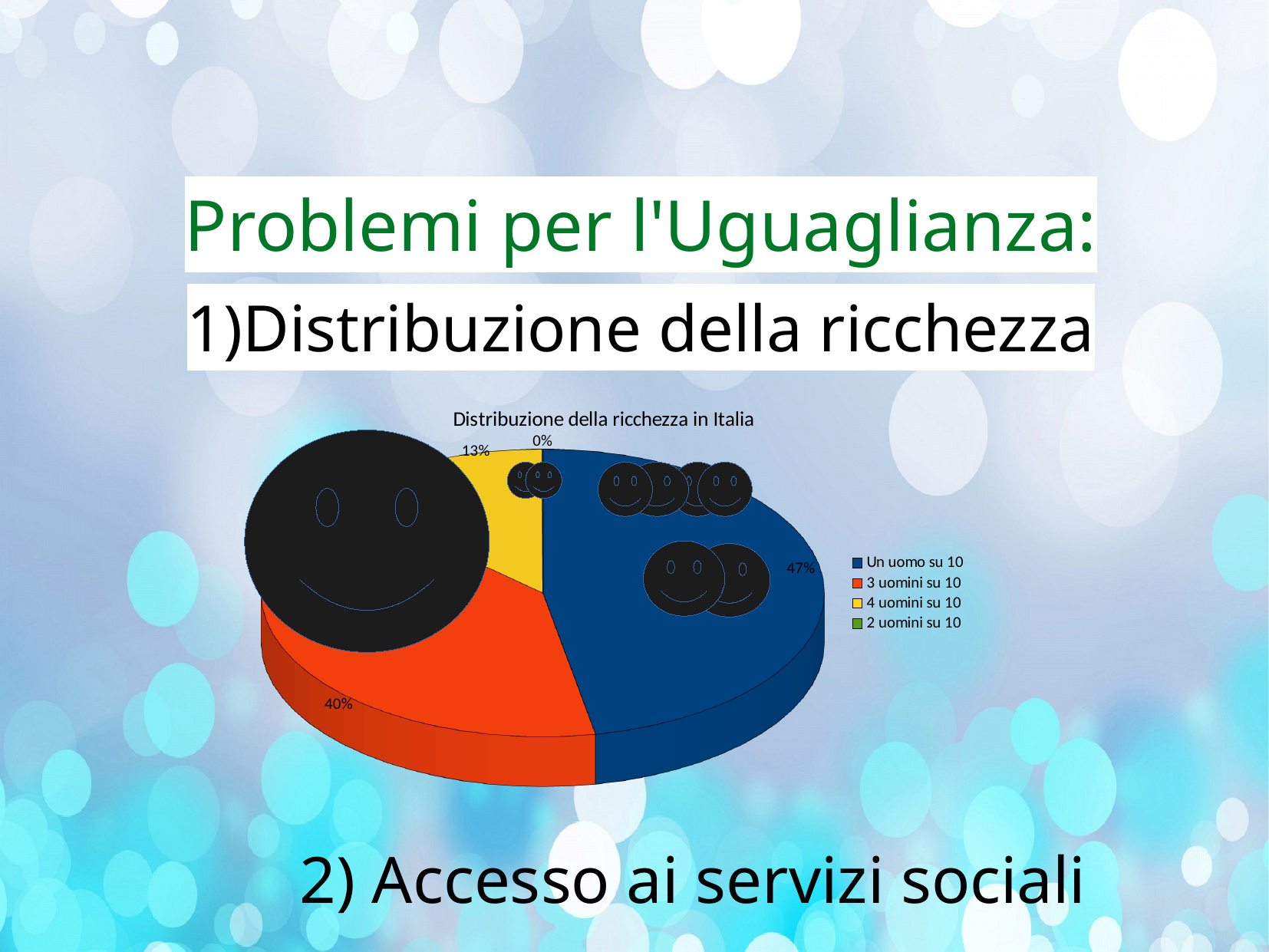
Which category has the largest slice of the pie? Un uomo su 10 What share of the pie does "4 uomini su 10" hold? 13% What share of the pie does "3 uomini su 10" hold? 40% How many entries does the legend list? 4 Which is larger, the share for "3 uomini su 10" or the share for "4 uomini su 10"? 3 uomini su 10 What is the difference between the shares of "Un uomo su 10" and "3 uomini su 10"? 7% What is the title of the pie chart? Distribuzione della ricchezza in Italia What colour is the slice for "4 uomini su 10"? yellow Which category has the smallest slice of the pie? 2 uomini su 10 What share of the pie does "Un uomo su 10" hold? 47% What kind of chart is shown on the slide? pie chart